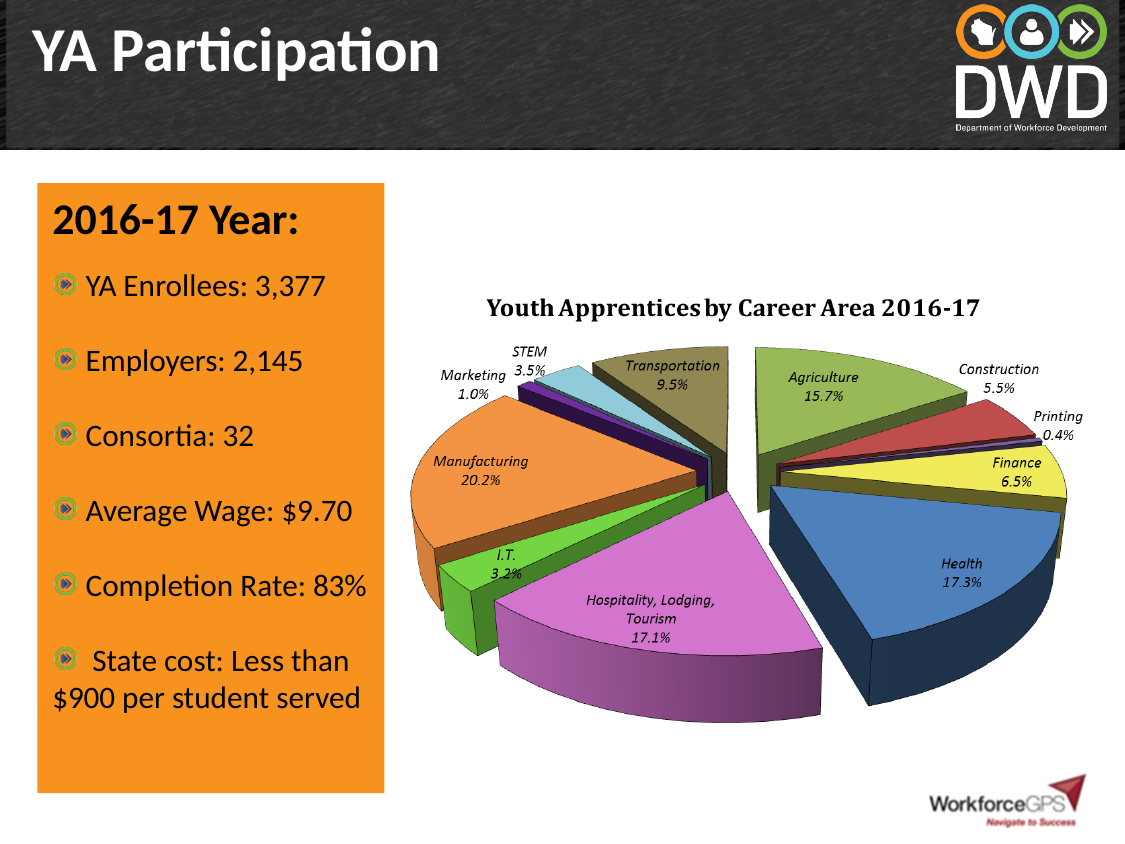
Which career area has the smallest share of youth apprentices? Printing What share of youth apprentices is in Agriculture? 15.7% Which has a larger share, Transportation or Finance? Transportation What is the title of the chart? Youth Apprentices by Career Area 2016-17 How many career areas are shown in the pie chart? 11 What is the difference in percentage points between Manufacturing and Health? 2.9 What is the difference in percentage points between Agriculture and Construction? 10.2 Which career area has the largest share of youth apprentices? Manufacturing What share of youth apprentices is in Health? 17.3% What kind of chart is shown on the slide? Pie chart What share of youth apprentices is in Manufacturing? 20.2% What share of youth apprentices is in Printing? 0.4%